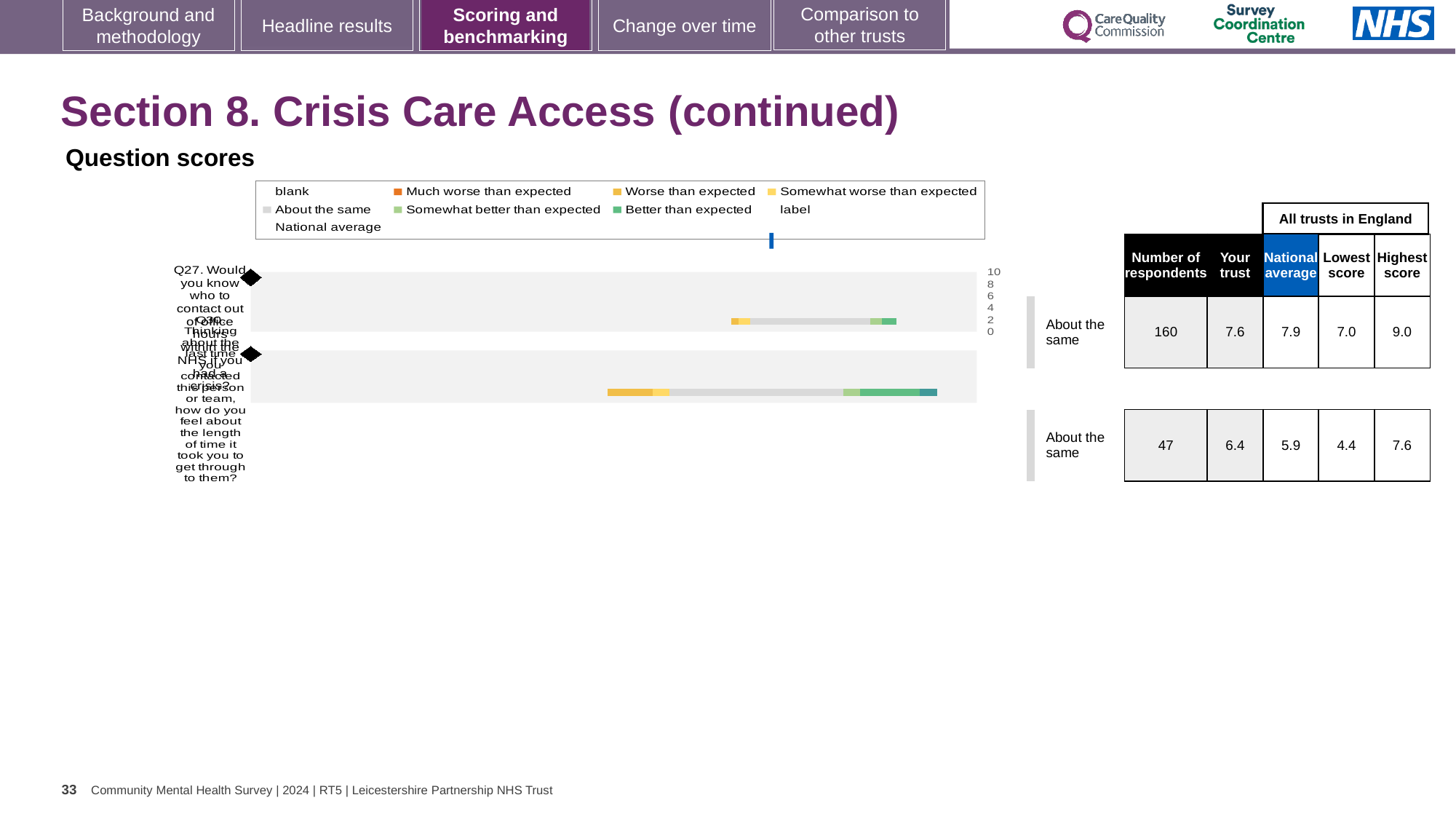
What benchmark category label is shown next to both Q27 and Q28? About the same In the table, what is the 'Your trust' score for Q27? 7.6 For Q27, what is the difference between the highest score and the lowest score across all trusts in England? 2.0 In the table, what is the number of respondents for Q27? 160 For Q28, which is larger: the 'Your trust' score or the national average? Your trust For Q27, which is larger: the 'Your trust' score or the national average? National average How many survey questions are plotted in the chart? 2 In the table, what is the national average for Q28? 5.9 In the table, what is the lowest score for Q28? 4.4 Which question has the higher number of respondents, Q27 or Q28? Q27 What kind of chart is shown under 'Question scores'? bar chart In the chart legend, which entry is shown in grey? About the same